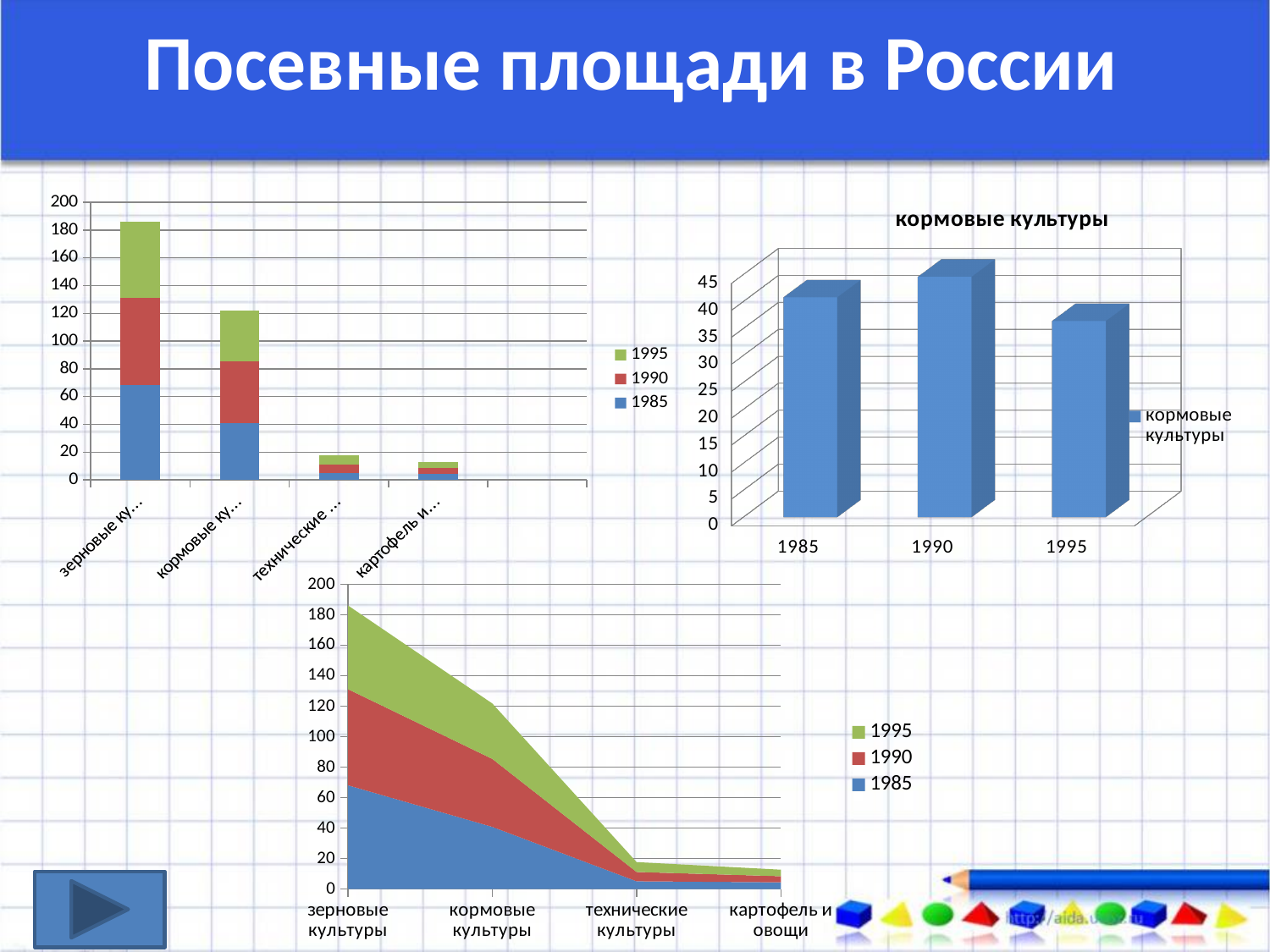
How many series does the legend of the top-left stacked bar chart list? 3 In the top-left stacked bar chart, is the total stacked value for the first category (зерновые) greater or less than 160? greater In the chart titled 'кормовые культуры', how many bars are plotted? 3 In the chart titled 'кормовые культуры', is the value for 1990 greater or less than 40? greater In the bottom area chart, do the stacked values rise or fall from left to right along the x axis? fall What is the title of the top-right chart? кормовые культуры In the top-left stacked bar chart, is the total stacked value for the second category (кормовые) greater or less than 100? greater In the top-left stacked bar chart, which category has the tallest stacked bar? зерновые культуры How many categories are shown on the x axis of the bottom area chart? 4 In the chart titled 'кормовые культуры', which year has the lowest value? 1995 In the chart titled 'кормовые культуры', which year has the highest value? 1990 What kind of chart is the top-left chart on the slide? stacked bar chart